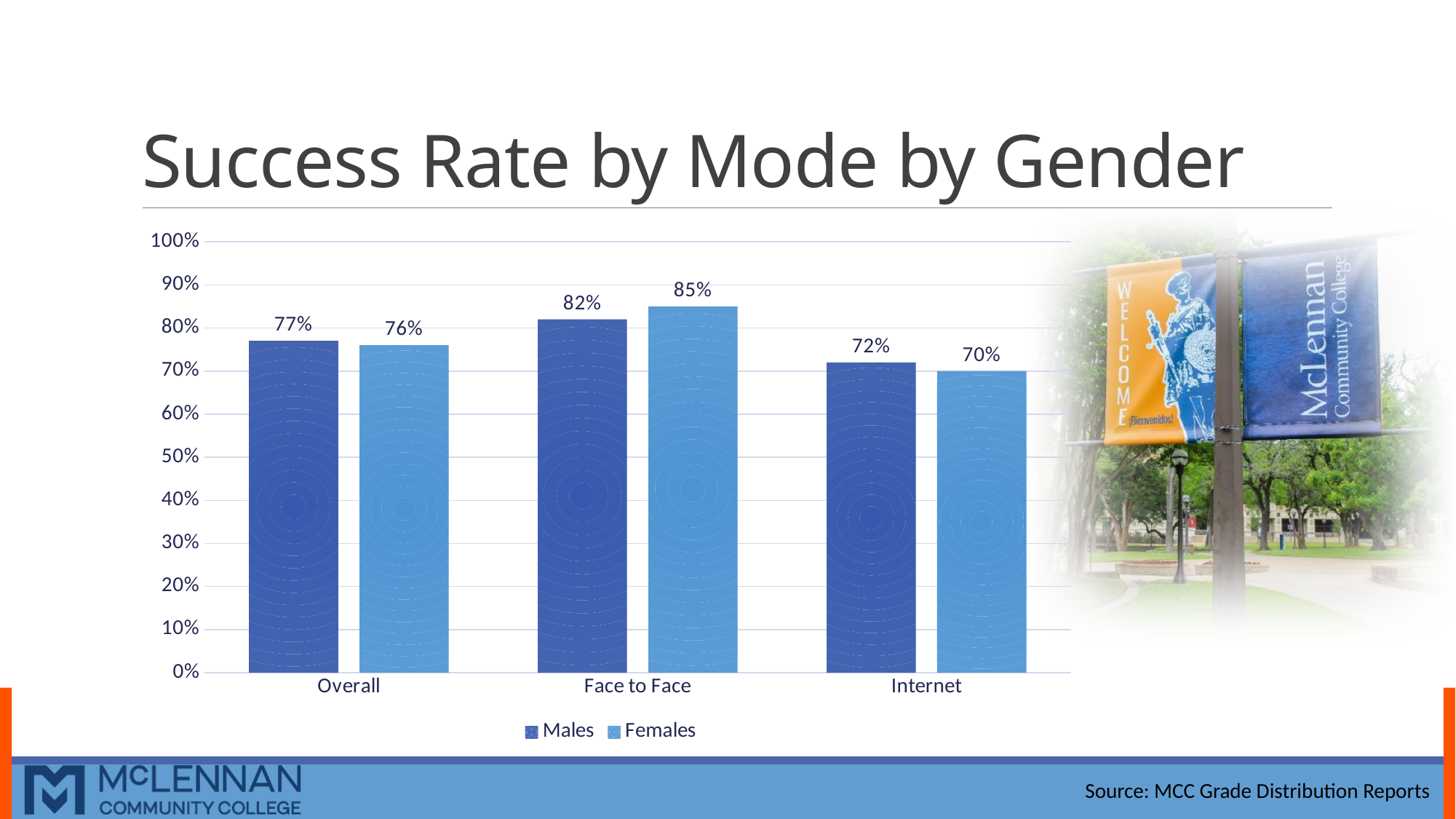
What is the difference between the Female and Male success rates in the Face to Face mode? 3% Is the Female success rate for Face to Face greater or less than 80%? greater What is the Overall success rate for Females? 76% What is the success rate for Males in the Face to Face mode? 82% Which mode has the highest success rate for Females? Face to Face How many modes are shown on the x axis? 3 What is the success rate for Females in the Internet mode? 70% Which mode has the lowest success rate for Males? Internet In the Internet mode, which group has the higher success rate, Males or Females? Males What kind of chart is shown on the slide? Bar chart What is the difference between the Male success rates for Face to Face and Internet? 10% How many series does the legend list? 2